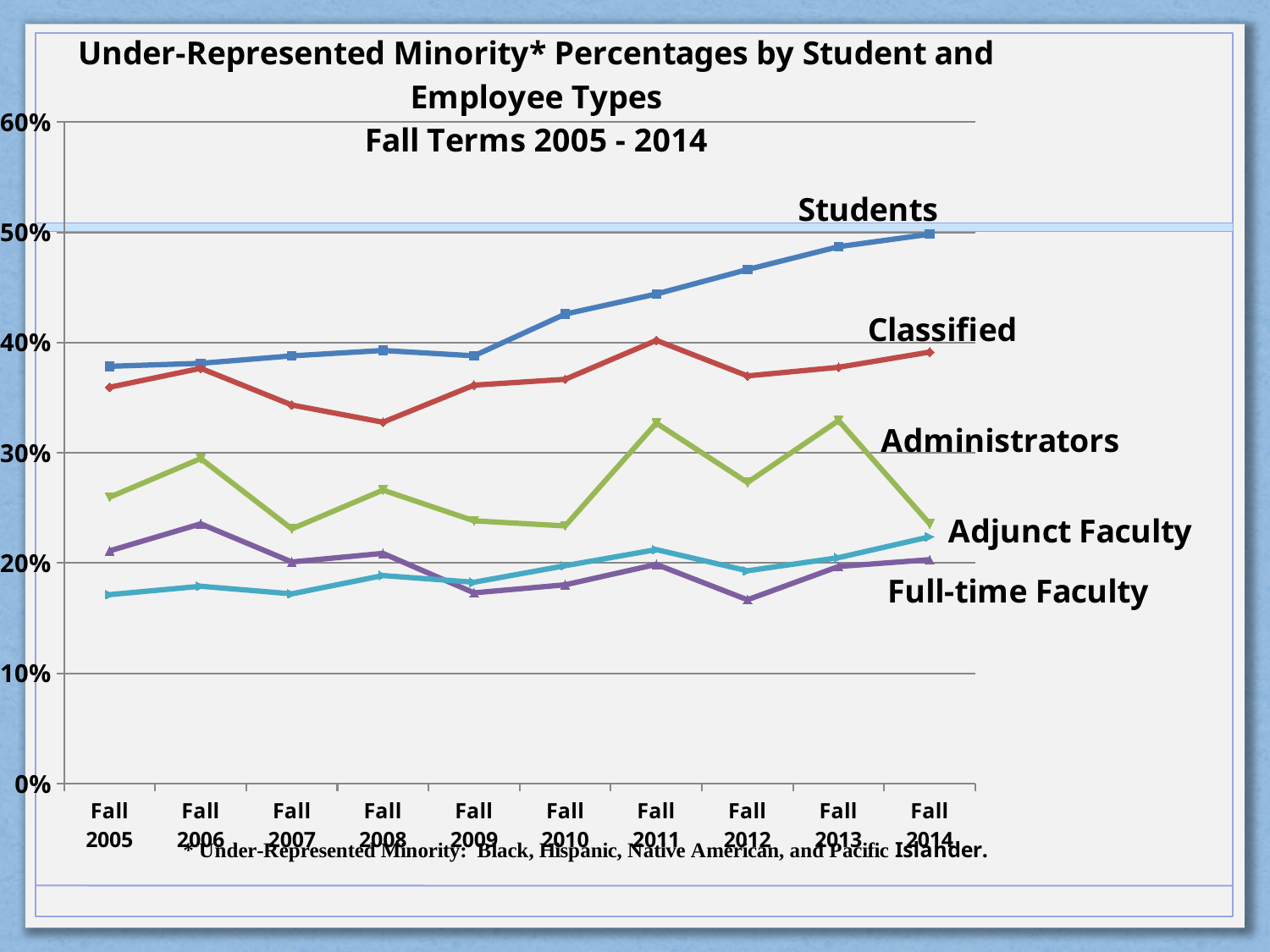
Is the value for Students in Fall 2005 greater or less than 40%? less Does the Students series rise or fall from Fall 2005 to Fall 2014? rise What kind of chart is shown on the slide? line chart Is the value for Administrators in Fall 2011 greater or less than 30%? greater How many series are plotted on the chart? 5 Is the value for Full-time Faculty in Fall 2012 greater or less than 20%? less Which groups does the footnote define as Under-Represented Minority? Black, Hispanic, Native American, and Pacific Islander Which series has the highest value in Fall 2014? Students Which series has the lowest value in Fall 2012? Full-time Faculty How many fall terms are plotted along the x axis? 10 In Fall 2013, which is larger: Classified or Administrators? Classified